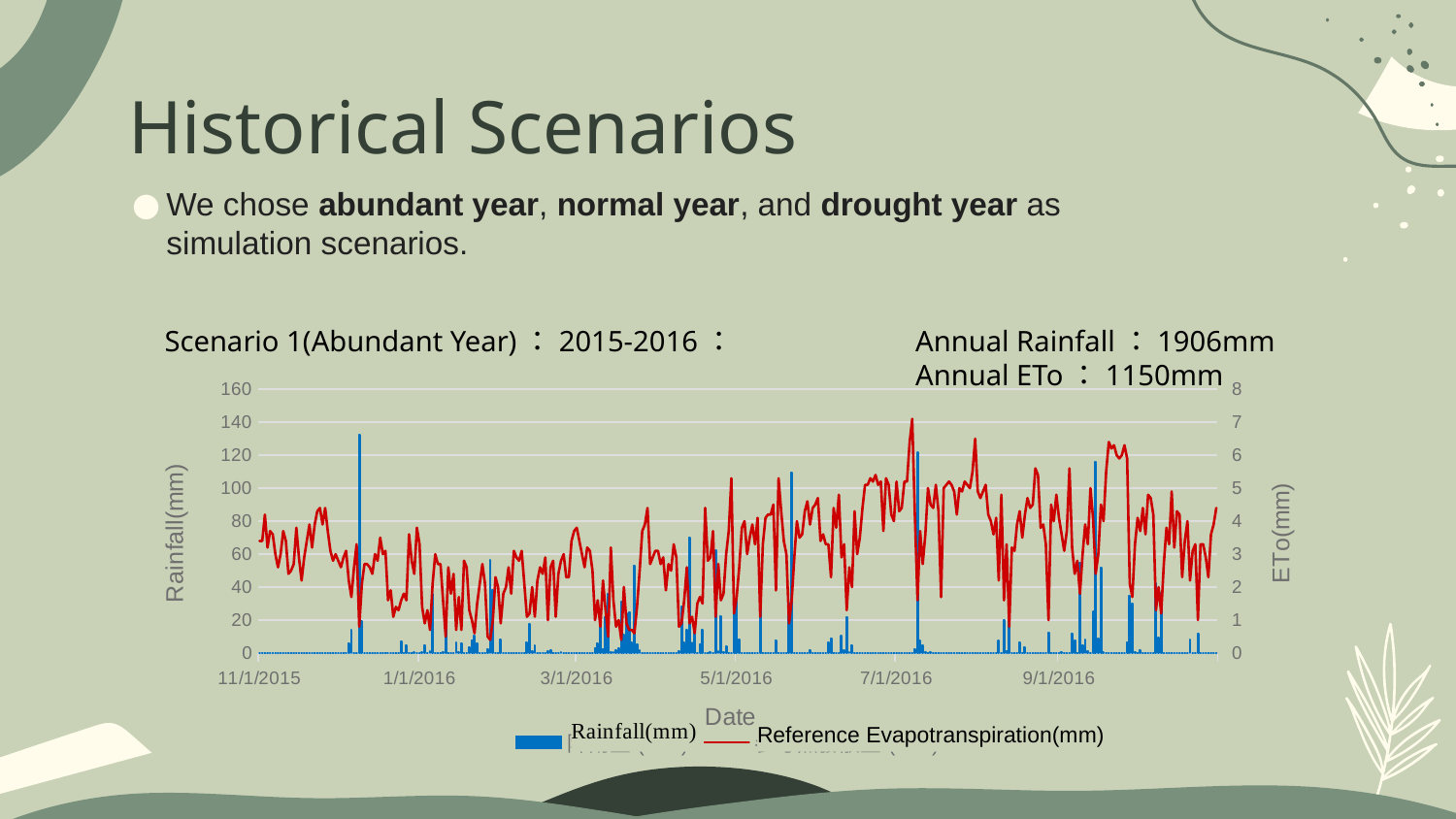
Is the highest value of the Reference Evapotranspiration line greater or less than 8 mm? less Which series is drawn as a red line in the chart? Reference Evapotranspiration(mm) How many series does the chart's legend list? 2 Does the Reference Evapotranspiration line generally rise or fall from 3/1/2016 to 7/1/2016? rise Is the highest value of the Reference Evapotranspiration line greater or less than 6 mm? greater Is the tallest rainfall bar in the chart greater or less than 120 mm? greater What kind of chart is shown on the slide? A combination bar and line chart Which series is drawn as blue bars in the chart? Rainfall(mm) What is the maximum value shown on the left (Rainfall) axis of the chart? 160 What is the maximum value shown on the right (ETo) axis of the chart? 8 How many date labels are shown along the x axis of the chart? 6